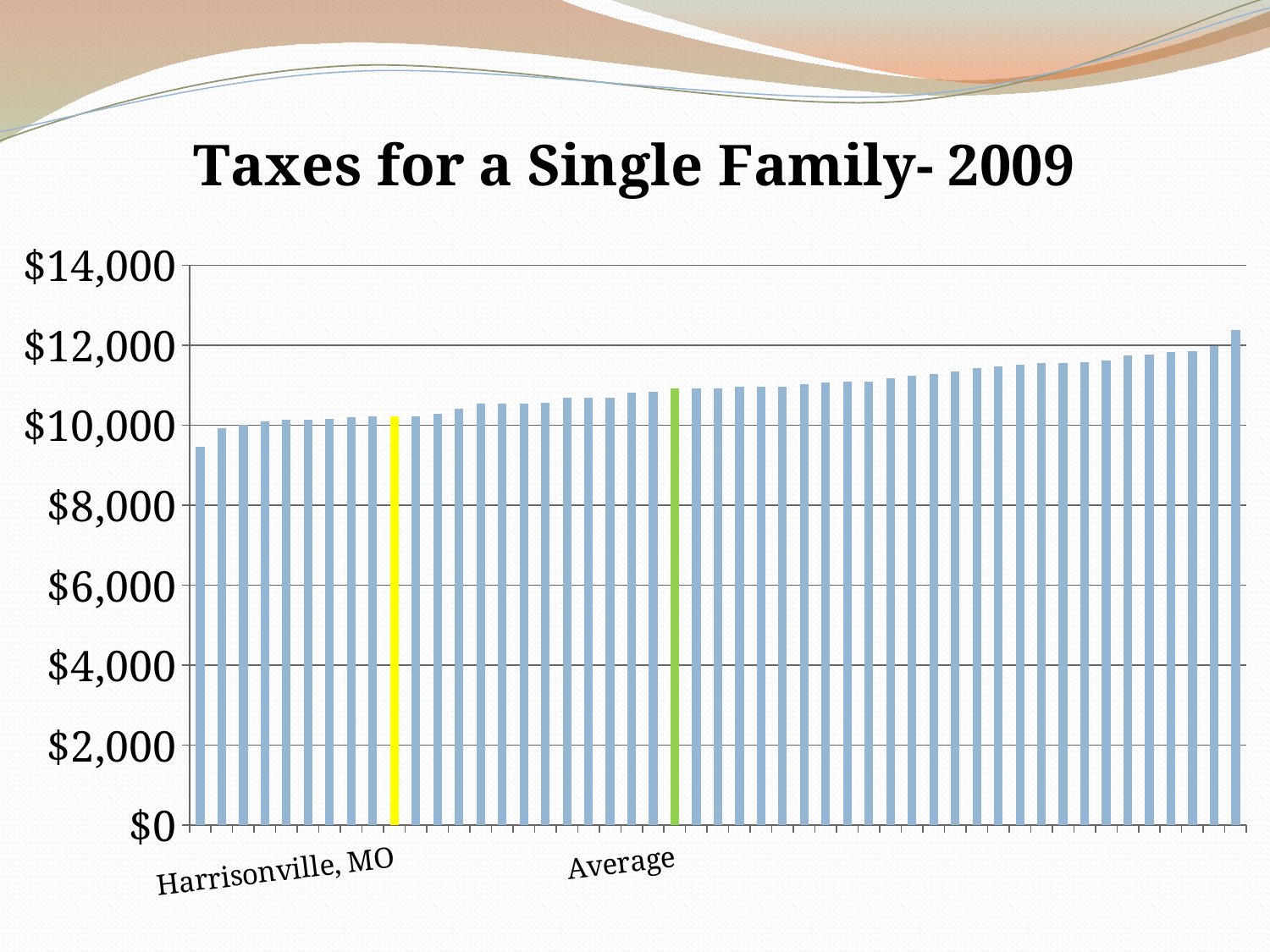
Is the value for Average greater or less than $12,000? less Is the shortest bar in the chart greater or less than $10,000? less Which is larger, the value for Harrisonville, MO or the value for Average? Average What is the title of the chart? Taxes for a Single Family- 2009 Is the value for Harrisonville, MO greater or less than $12,000? less What colour is the bar for Harrisonville, MO? yellow Do the bar values generally rise or fall from left to right along the x axis? rise What kind of chart is shown on the slide? bar chart